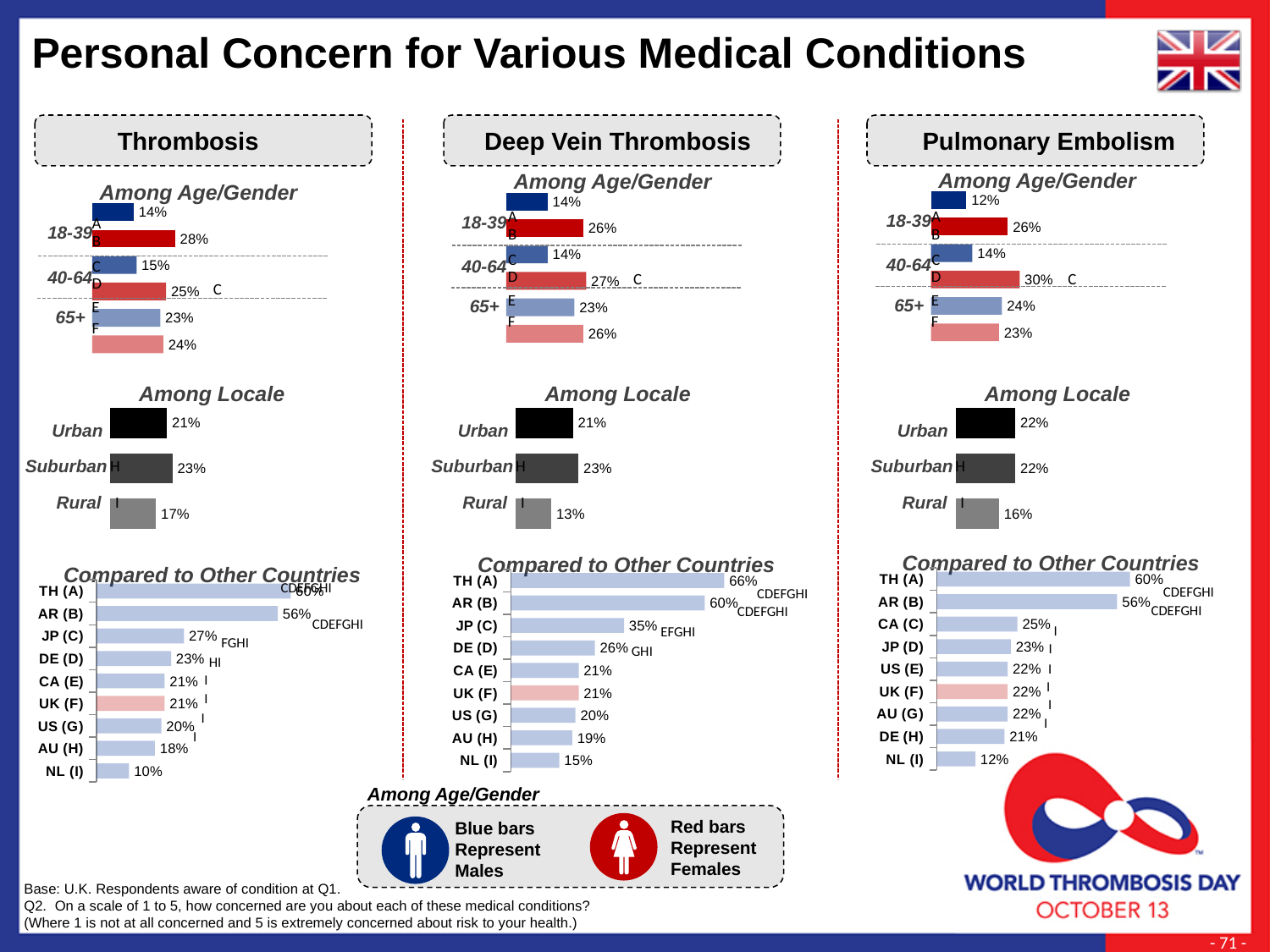
In the Deep Vein Thrombosis 'Compared to Other Countries' chart, which country has the highest value? TH (A) In the Deep Vein Thrombosis 'Compared to Other Countries' chart, what is the difference between TH (A) and AR (B)? 6% What type of chart is used for the 'Among Locale' sections on this slide? Bar chart In the Pulmonary Embolism 'Among Age/Gender' chart, what is the value for bar D (females 40-64)? 30% In the Pulmonary Embolism 'Compared to Other Countries' chart, which country has the lowest value? NL (I) How many countries are shown in the Pulmonary Embolism 'Compared to Other Countries' chart? 9 In the Deep Vein Thrombosis 'Among Locale' chart, what is the value for Rural? 13% According to the legend at the bottom of the slide, what do the red bars in the 'Among Age/Gender' charts represent? Females In the Thrombosis 'Among Locale' chart, which is larger, Suburban or Rural? Suburban In the Thrombosis 'Compared to Other Countries' chart, what is the value for UK (F)? 21% In the Pulmonary Embolism 'Among Locale' chart, what is the value for Urban? 22% In the Thrombosis 'Among Age/Gender' chart, what is the difference between bar B (28%) and bar A (14%)? 14%